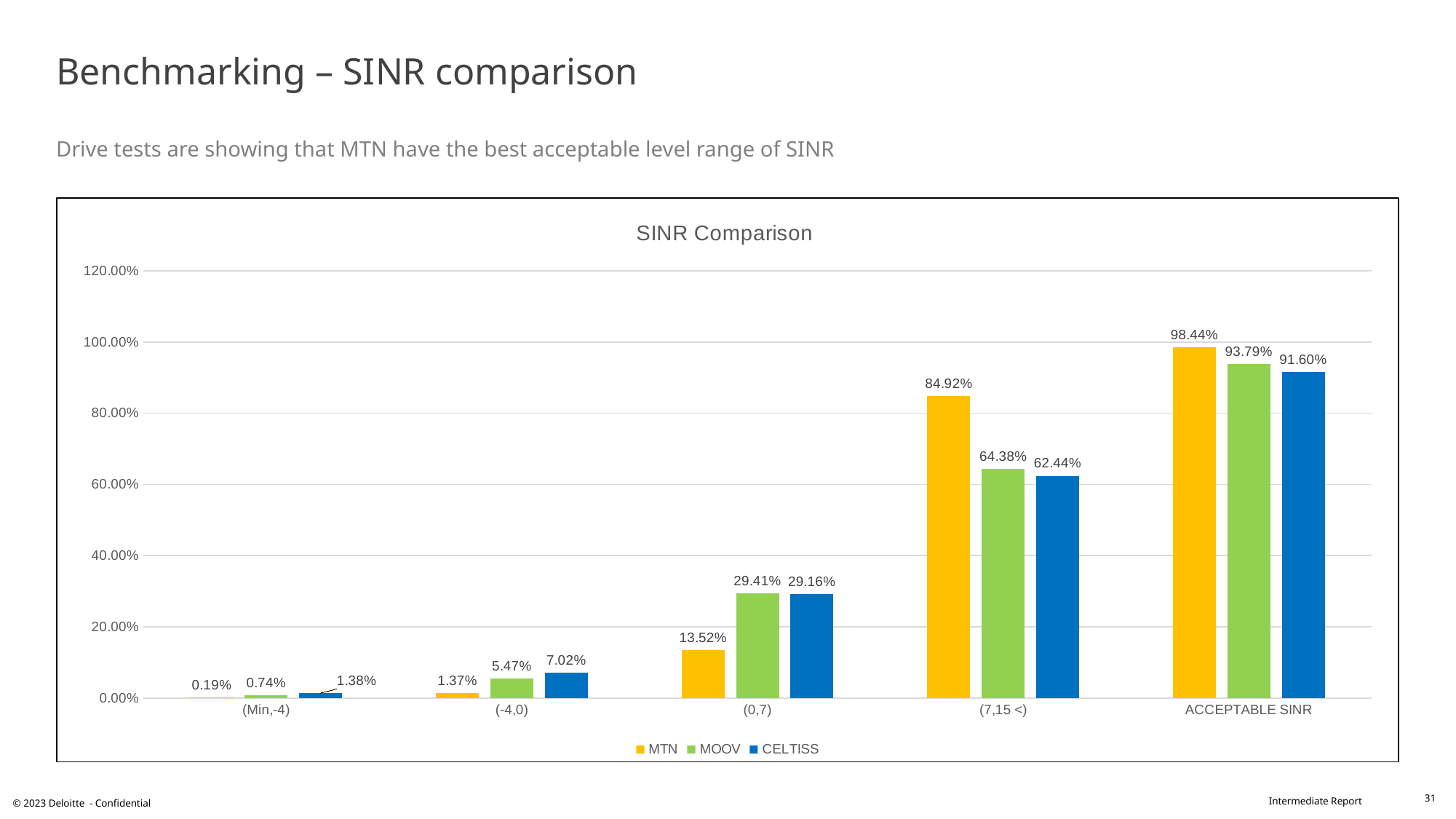
What is the difference between MTN and MOOV in the (7,15 <) category? 20.54% What kind of chart is shown? Bar chart Is the value for MTN in the (7,15 <) category greater or less than 80.00%? greater What is the value for MTN in the ACCEPTABLE SINR category? 98.44% Which is larger in the ACCEPTABLE SINR category, MOOV or CELTISS? MOOV How many categories are shown on the x axis? 5 Which series has the lowest value in the (Min,-4) category? MTN How many series does the legend list? 3 What is the value for MOOV in the (0,7) category? 29.41% Which series has the highest value in the (-4,0) category? CELTISS What is the value for CELTISS in the (7,15 <) category? 62.44% What is the title of the chart? SINR Comparison